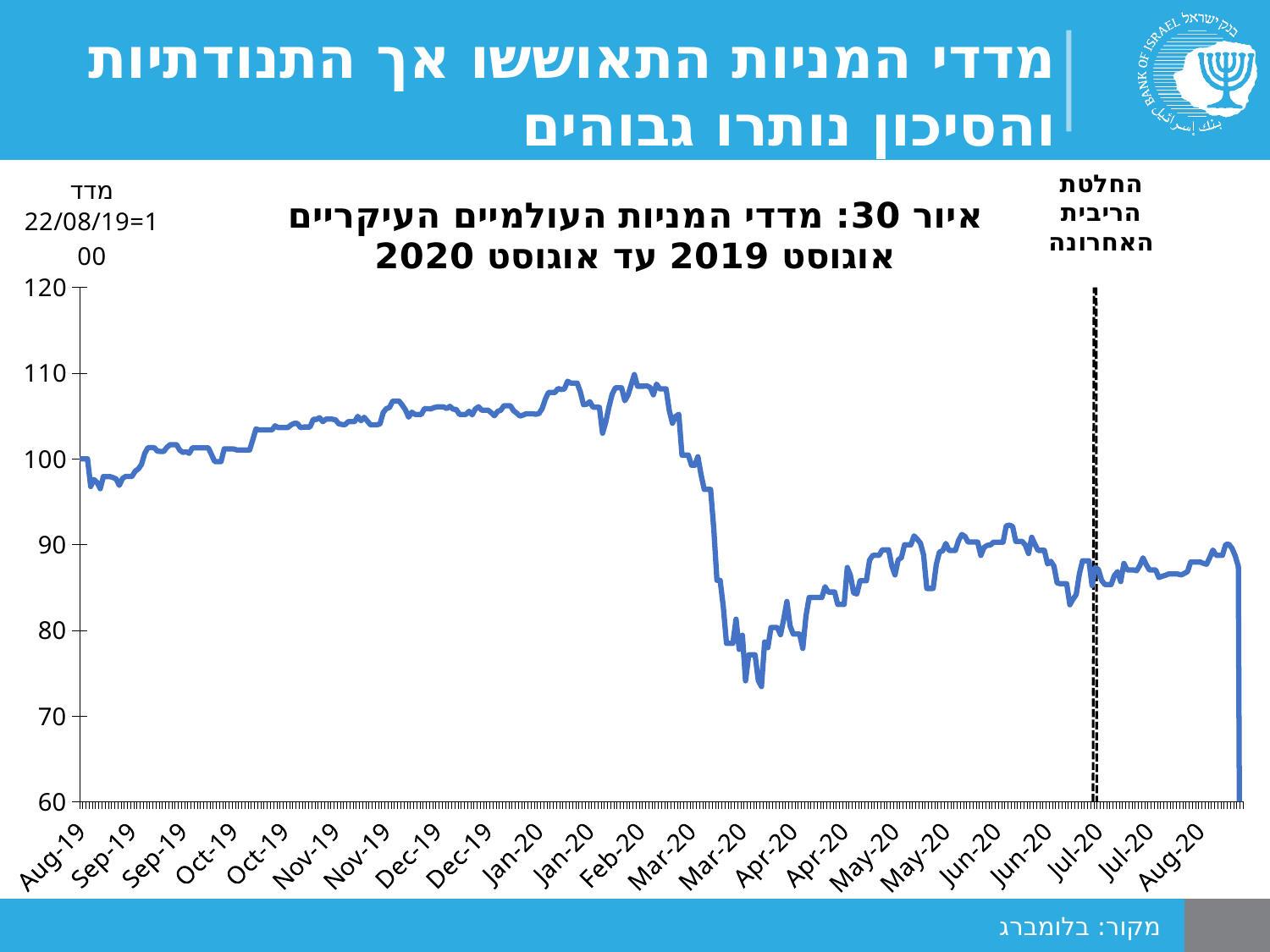
In which month does the index reach its highest value? Feb-20 In which month does the index reach its lowest value? Mar-20 What kind of chart is shown on the slide? line chart Does the index rise or fall overall from Aug-19 to Aug-20? fall Is the value of the index at the end of the series in Aug-20 greater or less than 100? less Is the lowest value of the index in Mar-20 greater or less than 80? less What is the index value on 22/08/19, the base date stated on the chart? 100 What does the dashed vertical line on the chart mark? החלטת הריבית האחרונה Is the value of the index in Nov-19 greater or less than 100? greater What is the title of the chart? איור 30: מדדי המניות העולמיים העיקריים אוגוסט 2019 עד אוגוסט 2020